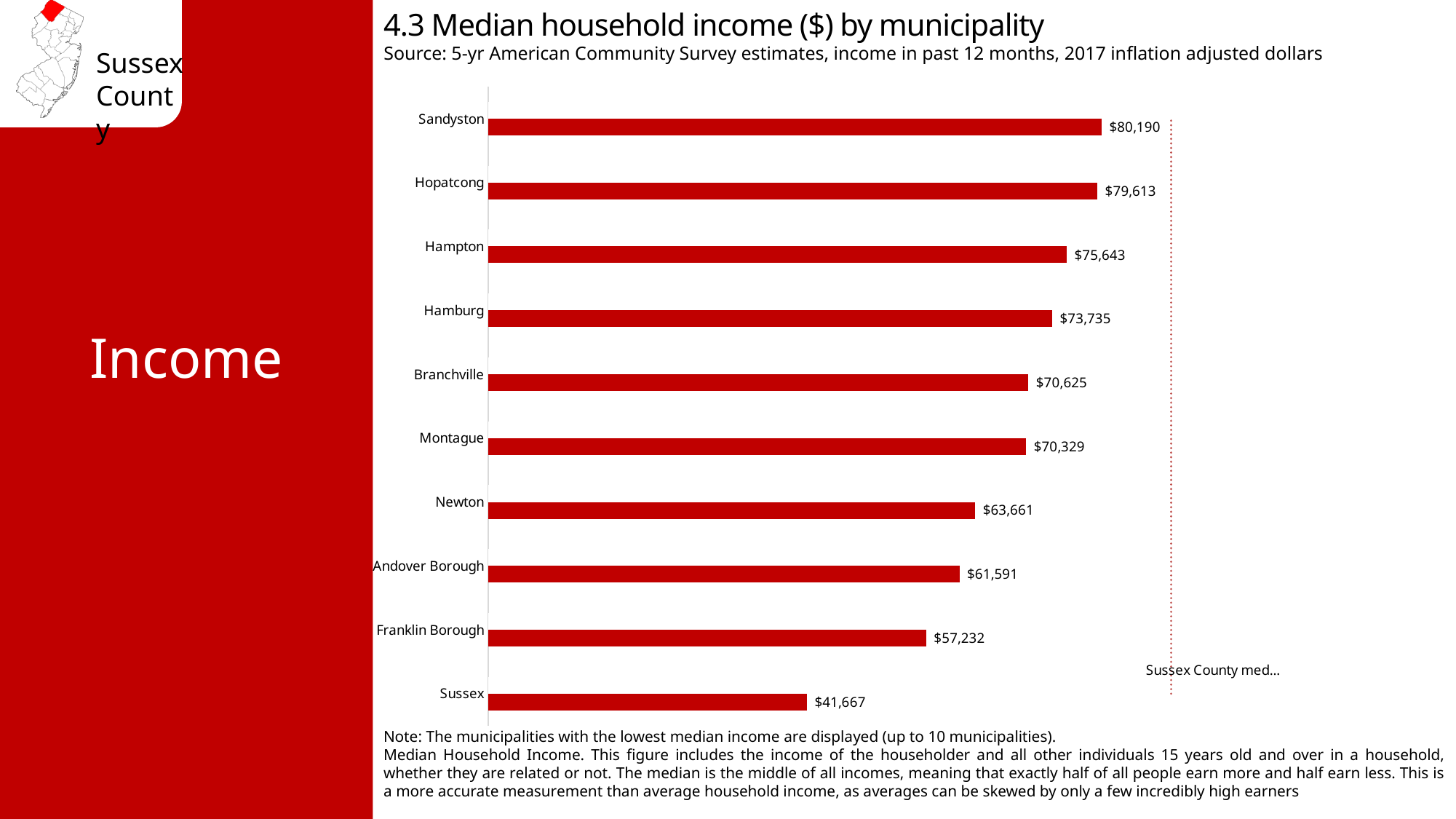
Which municipality has the highest median household income on the chart? Sandyston What is the median household income shown for Sandyston? $80,190 What is the median household income shown for Franklin Borough? $57,232 Which municipality has the lowest median household income on the chart? Sussex How many municipalities are shown on the chart? 10 Which has a higher median household income, Montague or Newton? Montague What is the median household income shown for Newton? $63,661 What is the difference between the median household income of Hampton and Hamburg? $1,908 What is the title of the chart? 4.3 Median household income ($) by municipality Which has a higher median household income, Andover Borough or Hamburg? Hamburg What is the difference between the median household income of Sandyston and Sussex? $38,523 What kind of chart is used to show median household income by municipality? Bar chart